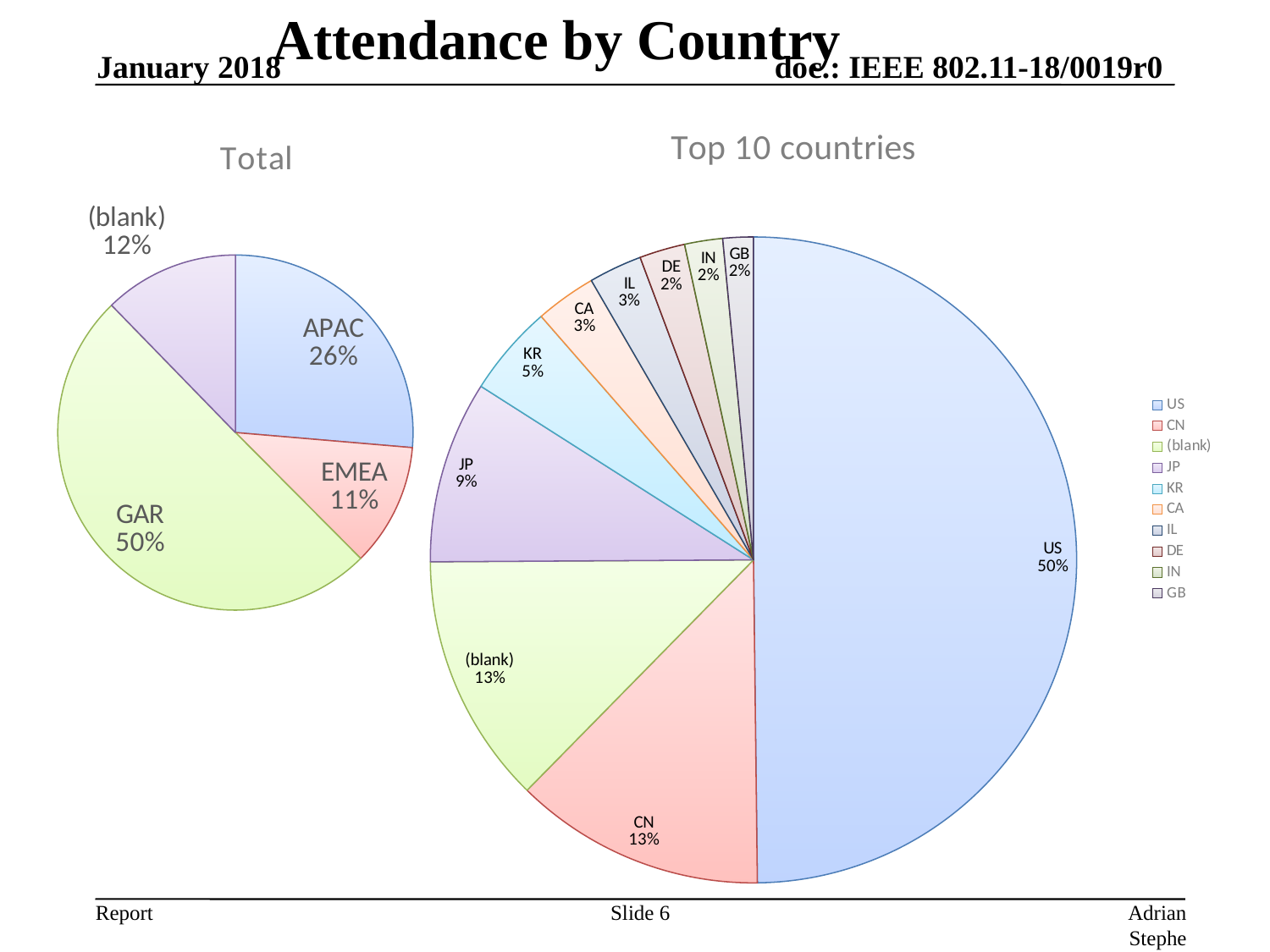
In the 'Total' chart, which category has the smallest share? EMEA In the 'Total' chart, what share does GAR have? 50% In the 'Total' chart, what is the difference between the shares of GAR and (blank)? 38% How many entries does the legend of the 'Top 10 countries' chart list? 10 In the 'Total' chart, what share does APAC have? 26% In the 'Total' chart, how many slices are there? 4 What kind of chart is the 'Top 10 countries' chart? Pie chart In the 'Top 10 countries' chart, what share does US have? 50% In the 'Top 10 countries' chart, which country has the largest share? US In the 'Top 10 countries' chart, which has the larger share, JP or CA? JP In the 'Top 10 countries' chart, what is the difference between the shares of CN and KR? 8%